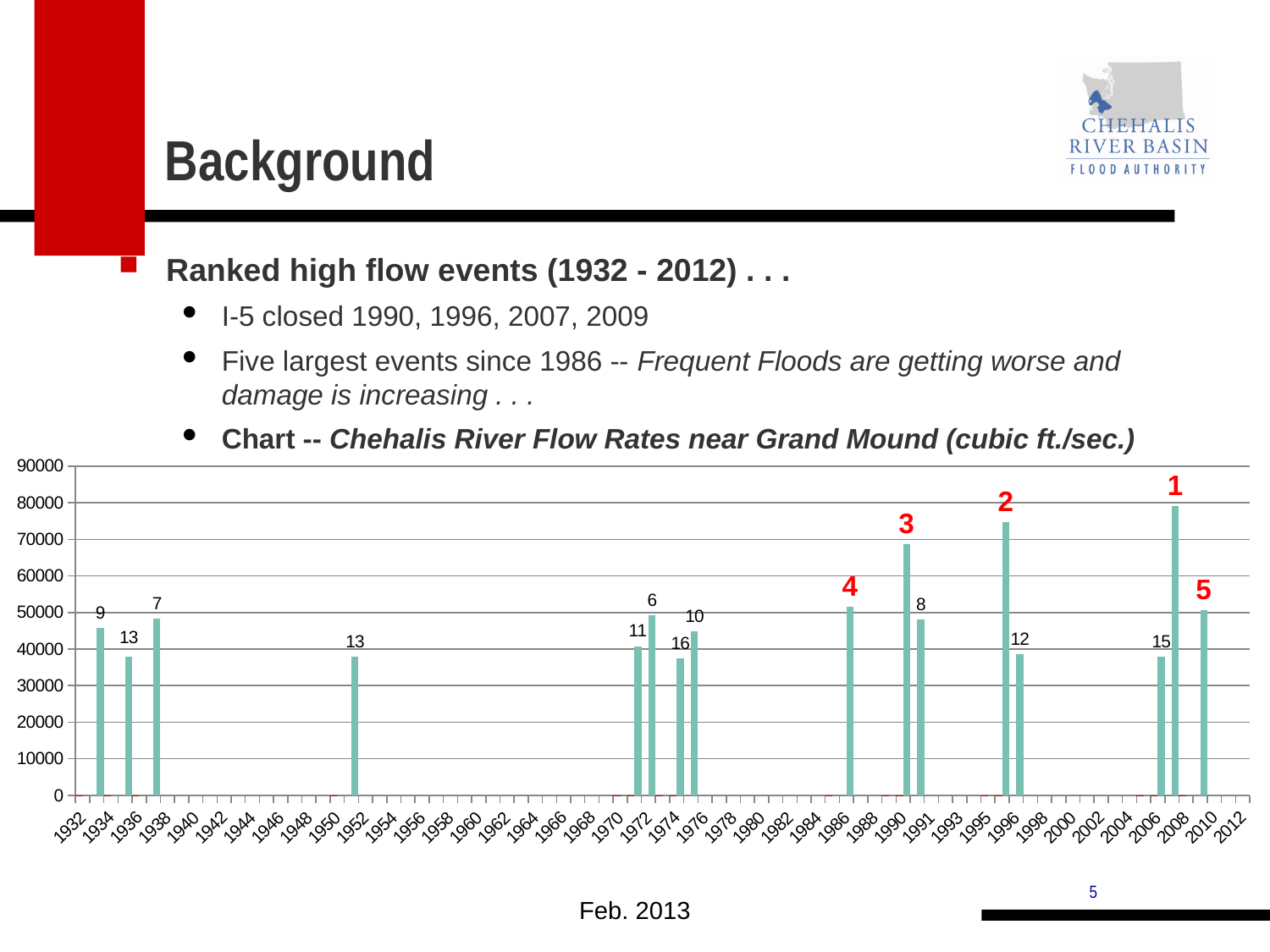
Is the value of the bar labeled 5 greater or less than 60000? less Is the value of the bar labeled 2 greater or less than 70000? greater Which rank label marks the tallest bar in the chart? 1 Is the value of the bar labeled 16 greater or less than 40000? less What is the title of the chart on the slide? Chehalis River Flow Rates near Grand Mound (cubic ft./sec.) Which is larger, the bar labeled 1 or the bar labeled 2? the bar labeled 1 What kind of chart is shown on the slide? bar chart How many bars (high flow events) are plotted in the chart? 16 What is the highest value shown on the chart's vertical axis? 90000 Which is larger, the bar labeled 3 or the bar labeled 8? the bar labeled 3